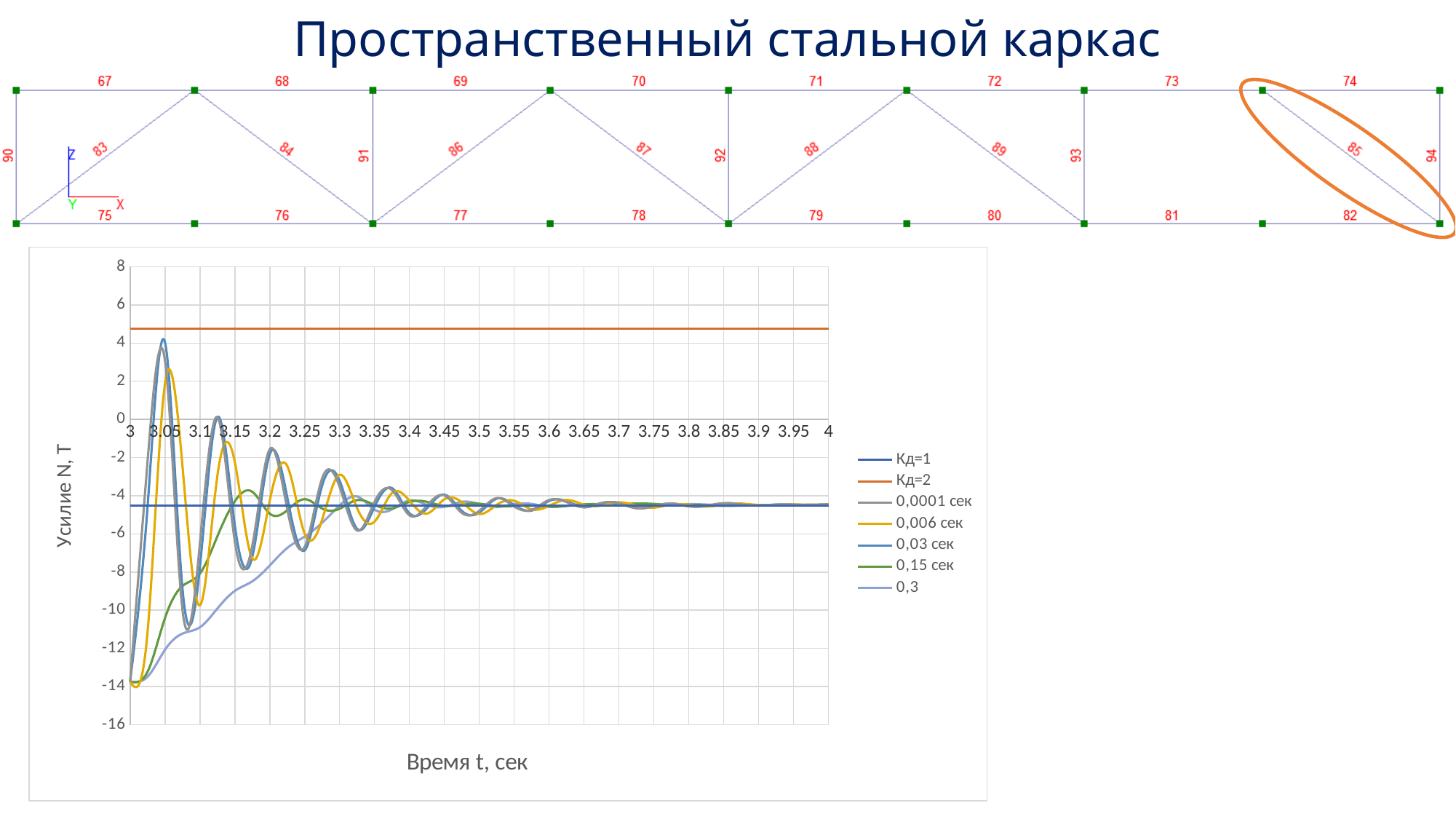
What is the label of the chart's horizontal axis? Время t, сек What kind of chart is shown on the slide? line chart Which of the two series, Кд=1 or Кд=2, has the larger value? Кд=2 Is the constant value of the Кд=1 series greater or less than -4? less Is the constant value of the Кд=2 series greater or less than 4? greater Which series has the highest value anywhere on the chart? Кд=2 How many series does the chart legend list? 7 Is the value of the 0,3 series at t = 3.1 greater or less than -10? less What is the lowest value shown on the vertical axis of the chart? -16 Does the 0,3 series rise or fall as time increases from 3 to 4 seconds? rise What is the label of the chart's vertical axis? Усилие N, Т